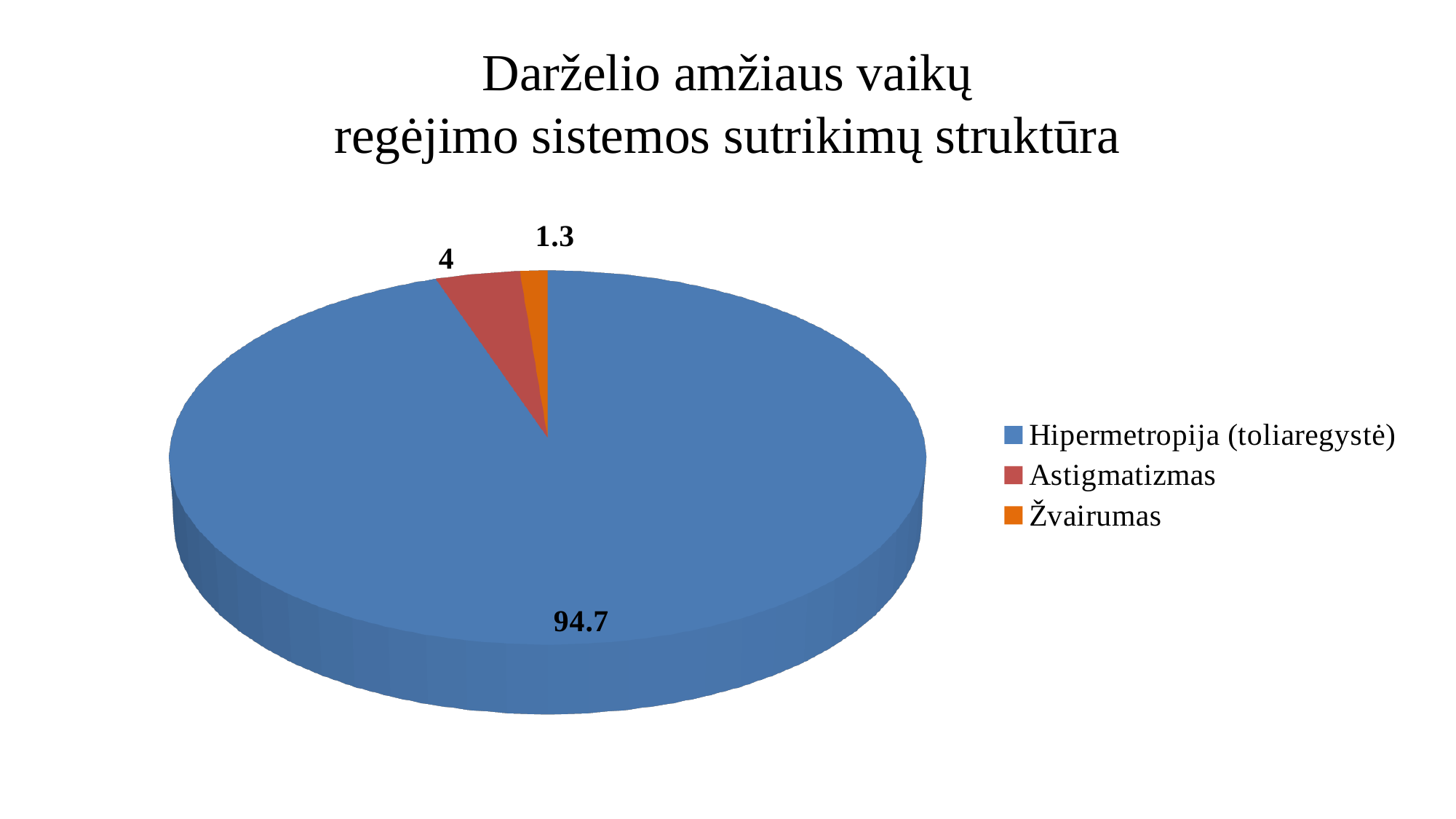
What kind of chart is shown on the slide? Pie chart What value is shown for Astigmatizmas? 4 What value is shown for Žvairumas? 1.3 What value is shown for Hipermetropija (toliaregystė)? 94.7 How many entries does the legend list? 3 How many categories does the pie chart show? 3 What colour is the slice for Astigmatizmas? Red Which category has the smallest slice of the pie? Žvairumas Which is larger, the value for Astigmatizmas or the value for Žvairumas? Astigmatizmas Which category has the largest slice of the pie? Hipermetropija (toliaregystė) What is the difference between the values for Hipermetropija (toliaregystė) and Astigmatizmas? 90.7 What is the difference between the values for Astigmatizmas and Žvairumas? 2.7